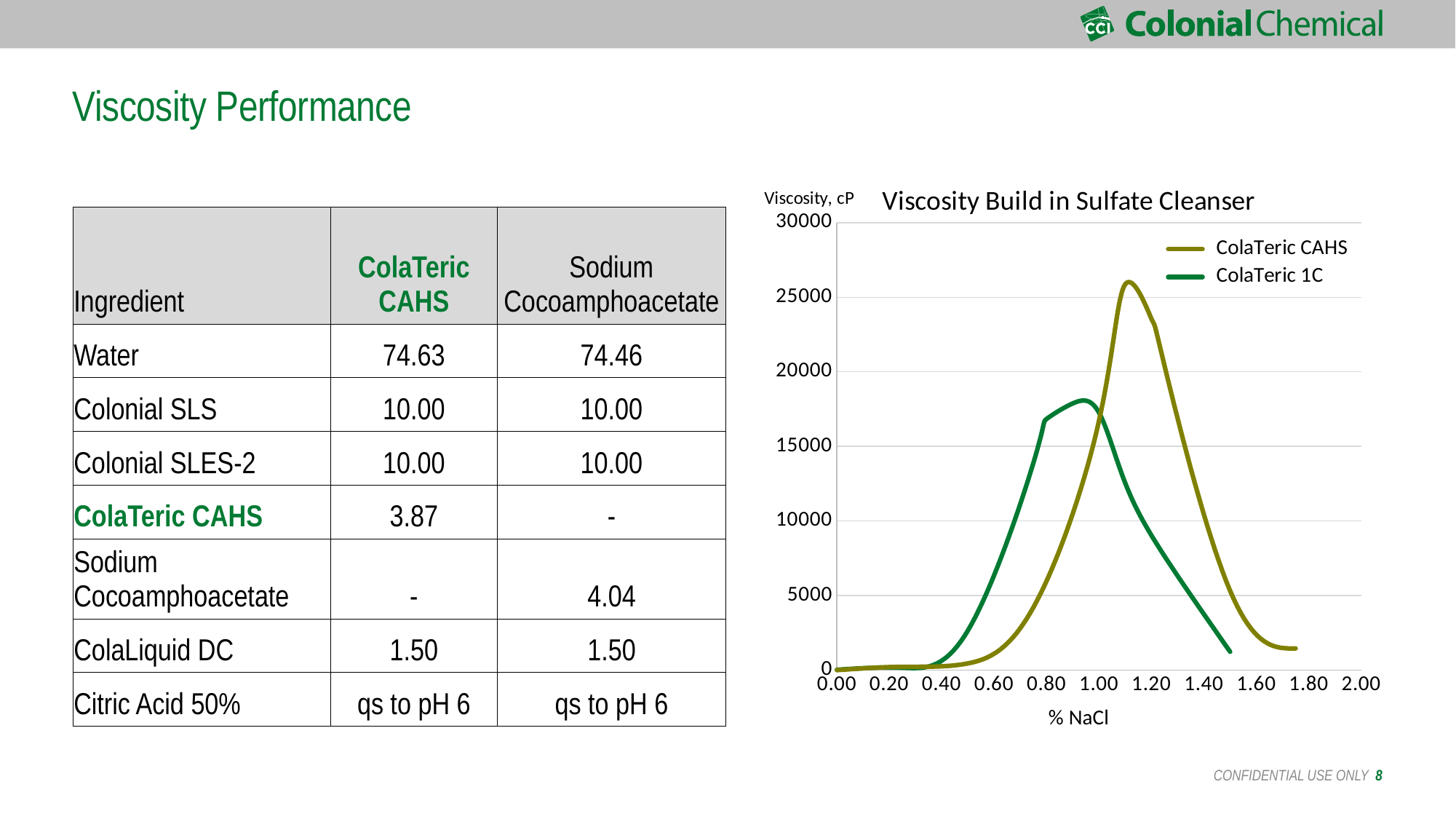
In the "Viscosity Build in Sulfate Cleanser" chart, which series reaches its peak viscosity at a lower % NaCl? ColaTeric 1C In the "Viscosity Build in Sulfate Cleanser" chart, is the viscosity of ColaTeric CAHS at 1.20 % NaCl greater or less than 20000? greater In the "Viscosity Build in Sulfate Cleanser" chart, is the peak viscosity of ColaTeric CAHS greater or less than 20000? greater In the "Viscosity Build in Sulfate Cleanser" chart, does the ColaTeric CAHS viscosity rise or fall between 1.20 and 1.60 % NaCl? fall What is the x-axis label of the "Viscosity Build in Sulfate Cleanser" chart? % NaCl In the "Viscosity Build in Sulfate Cleanser" chart, is the peak viscosity of ColaTeric 1C greater or less than 20000? less How many series does the legend of the "Viscosity Build in Sulfate Cleanser" chart list? 2 What is the title of the chart on the slide? Viscosity Build in Sulfate Cleanser What kind of chart is "Viscosity Build in Sulfate Cleanser"? line chart In the "Viscosity Build in Sulfate Cleanser" chart, which series reaches the higher peak viscosity? ColaTeric CAHS In the "Viscosity Build in Sulfate Cleanser" chart, does the ColaTeric 1C viscosity rise or fall between 0.40 and 0.80 % NaCl? rise